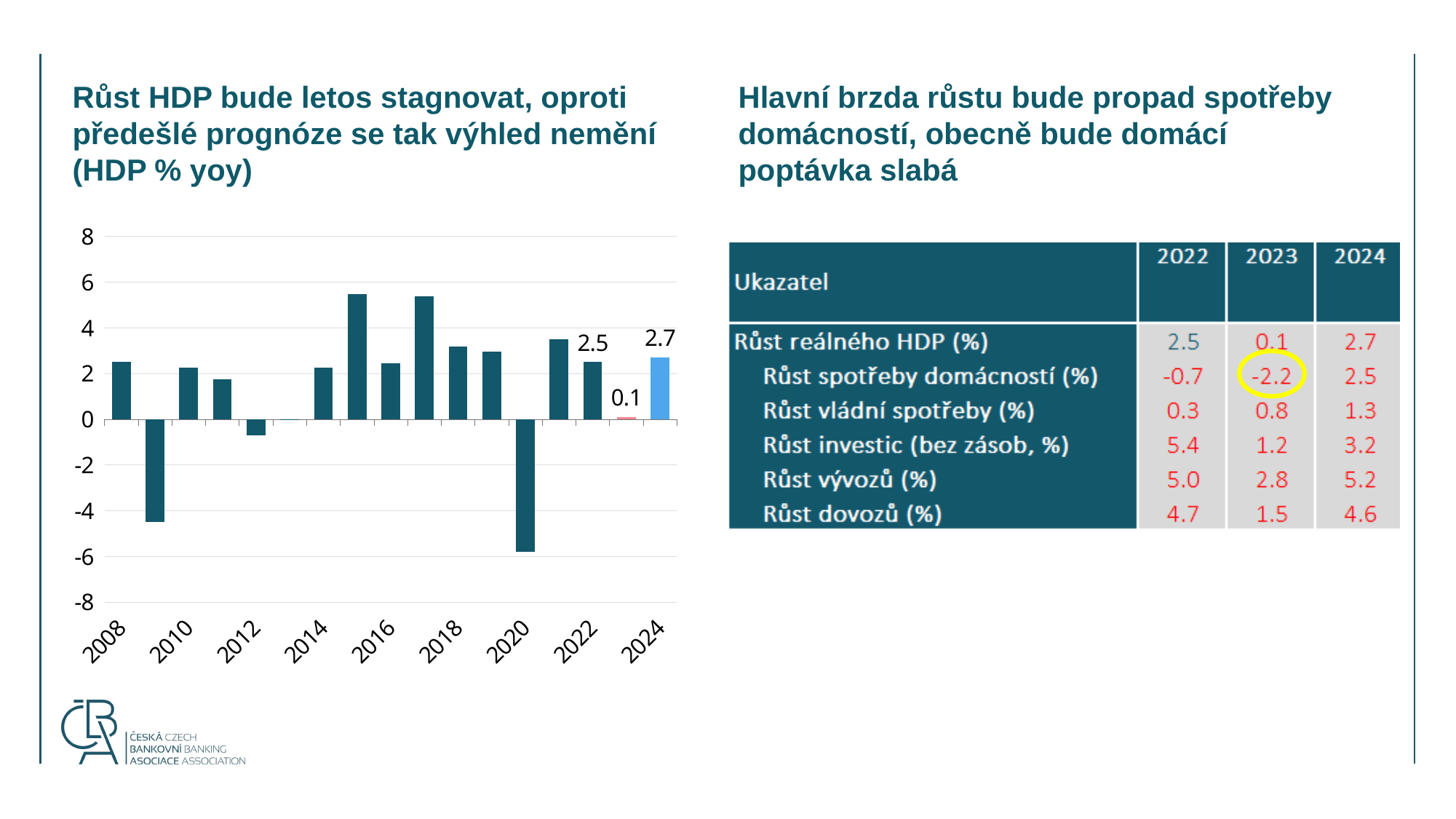
Which is larger in the bar chart, the value for 2022 or the value for 2024? 2024 Is the value for 2020 in the bar chart greater or less than -4? less Which year has the lowest value in the bar chart? 2020 Does the value in the bar chart rise or fall from 2022 to 2023? fall What is the value shown for 2023 in the bar chart? 0.1 What colour is the bar for 2024 in the bar chart? light blue Is the value for 2018 in the bar chart greater or less than 2? greater What is the value shown for 2022 in the bar chart? 2.5 How many bars (years) are plotted in the bar chart? 17 What kind of chart is shown on the left of the slide? bar chart What is the difference between the values for 2024 and 2023 in the bar chart? 2.6 What is the value shown for 2024 in the bar chart? 2.7